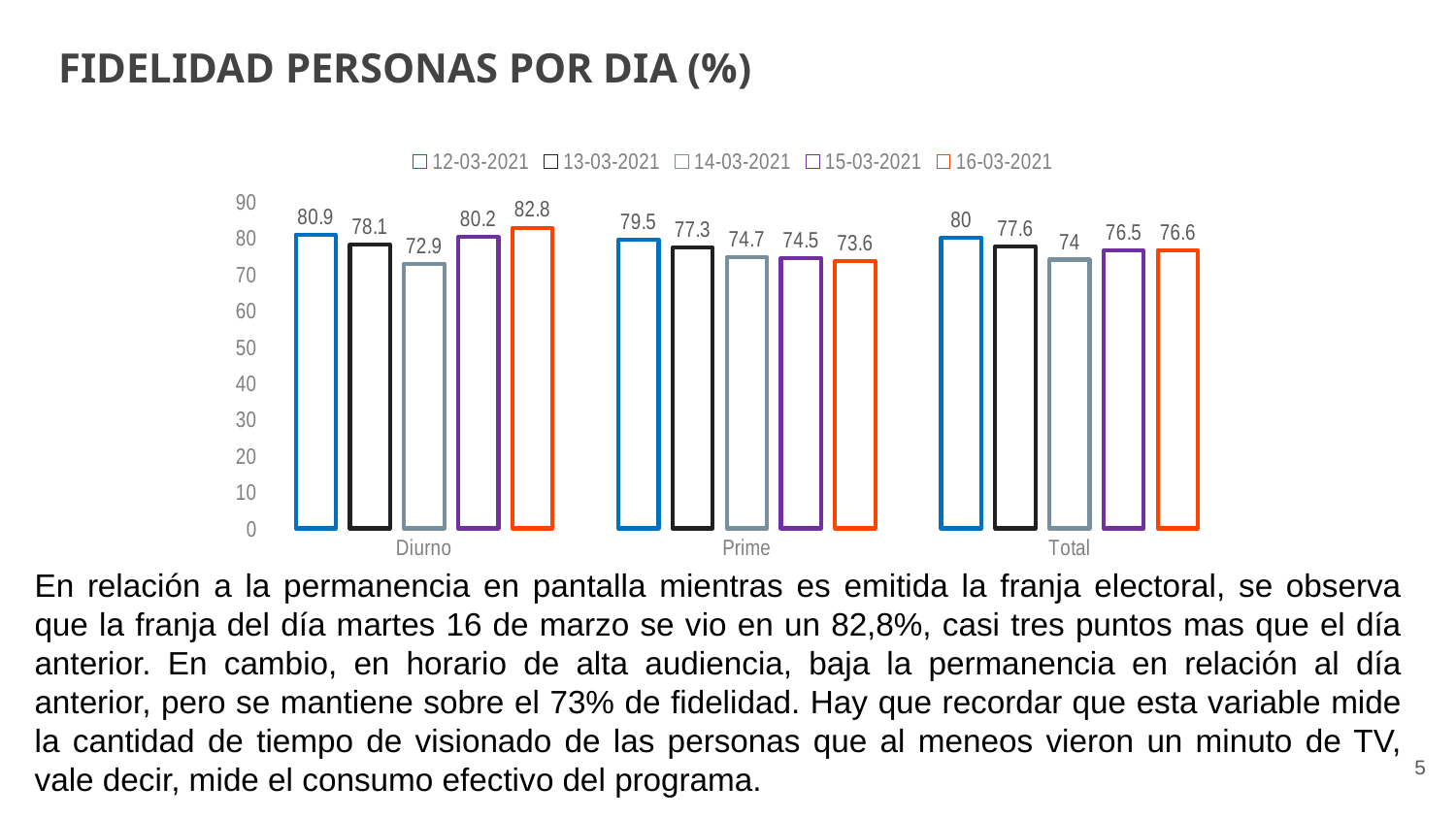
What kind of chart is shown on the slide? Bar chart How many series does the legend list? 5 What is the value for 14-03-2021 in the Prime category? 74.7 Which date has the lowest value in the Prime category? 16-03-2021 What is the difference between the 16-03-2021 and 15-03-2021 values in the Diurno category? 2.6 Which is larger in the Prime category: the value for 12-03-2021 or the value for 13-03-2021? 12-03-2021 What is the title of the chart? FIDELIDAD PERSONAS POR DIA (%) What is the value for 12-03-2021 in the Total category? 80 Which date has the lowest value in the Total category? 14-03-2021 How many categories are shown on the x axis? 3 Which date has the highest value in the Diurno category? 16-03-2021 What is the value for 16-03-2021 in the Diurno category? 82.8